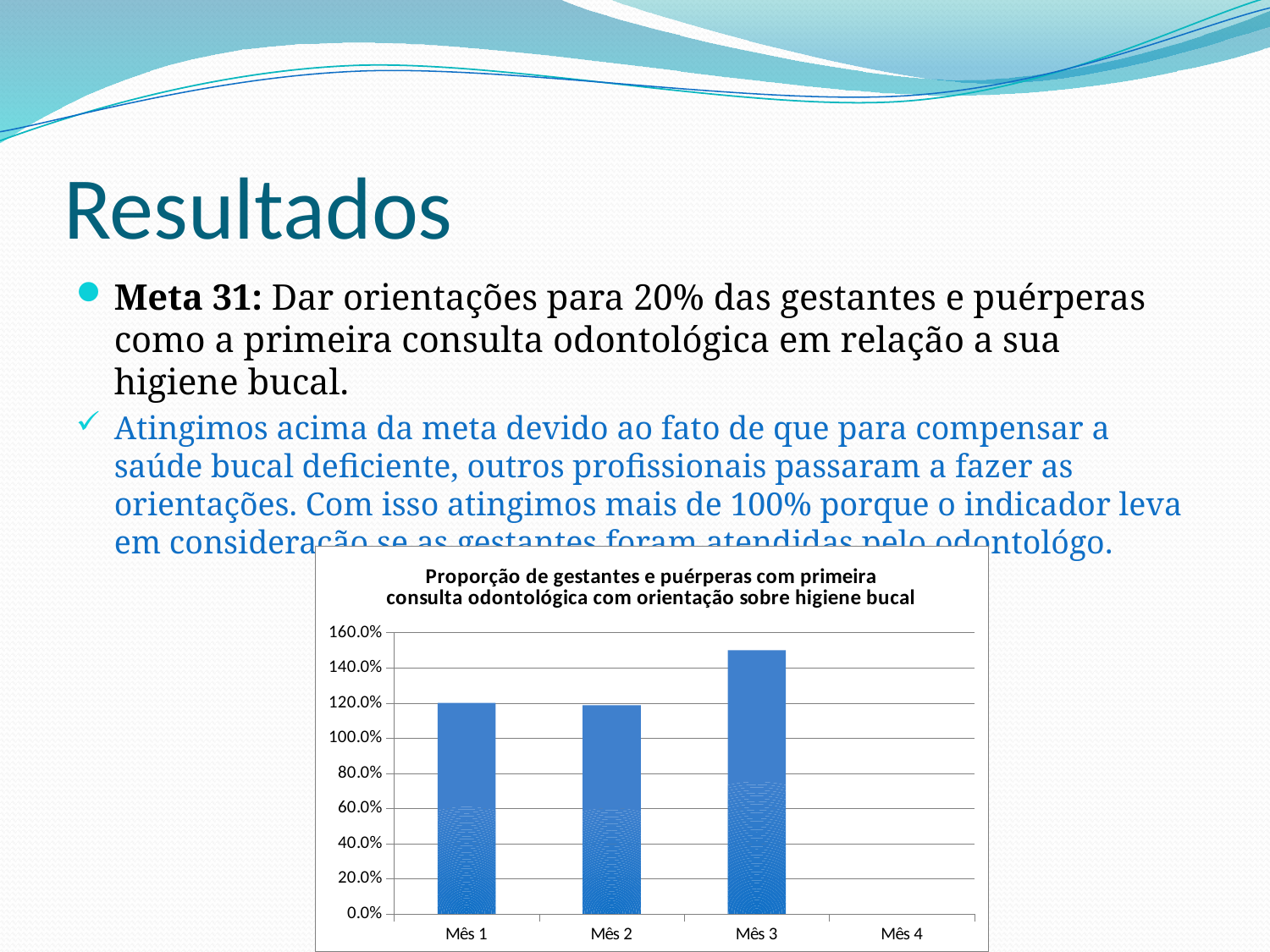
What is the highest tick value shown on the y axis of the chart? 160.0% What is the title of the chart? Proporção de gestantes e puérperas com primeira consulta odontológica com orientação sobre higiene bucal Which is larger, the value for Mês 3 or the value for Mês 1? Mês 3 Does the value rise or fall from Mês 2 to Mês 3? Rise Is the value for Mês 3 greater or less than 140.0%? greater Is the value for Mês 1 greater or less than 100.0%? greater How many month categories are shown on the x axis of the chart? 4 Is the value for Mês 2 greater or less than 140.0%? less Which month has the highest value in the chart? Mês 3 Which month category shows no bar in the chart? Mês 4 What kind of chart is shown on the slide? Bar chart